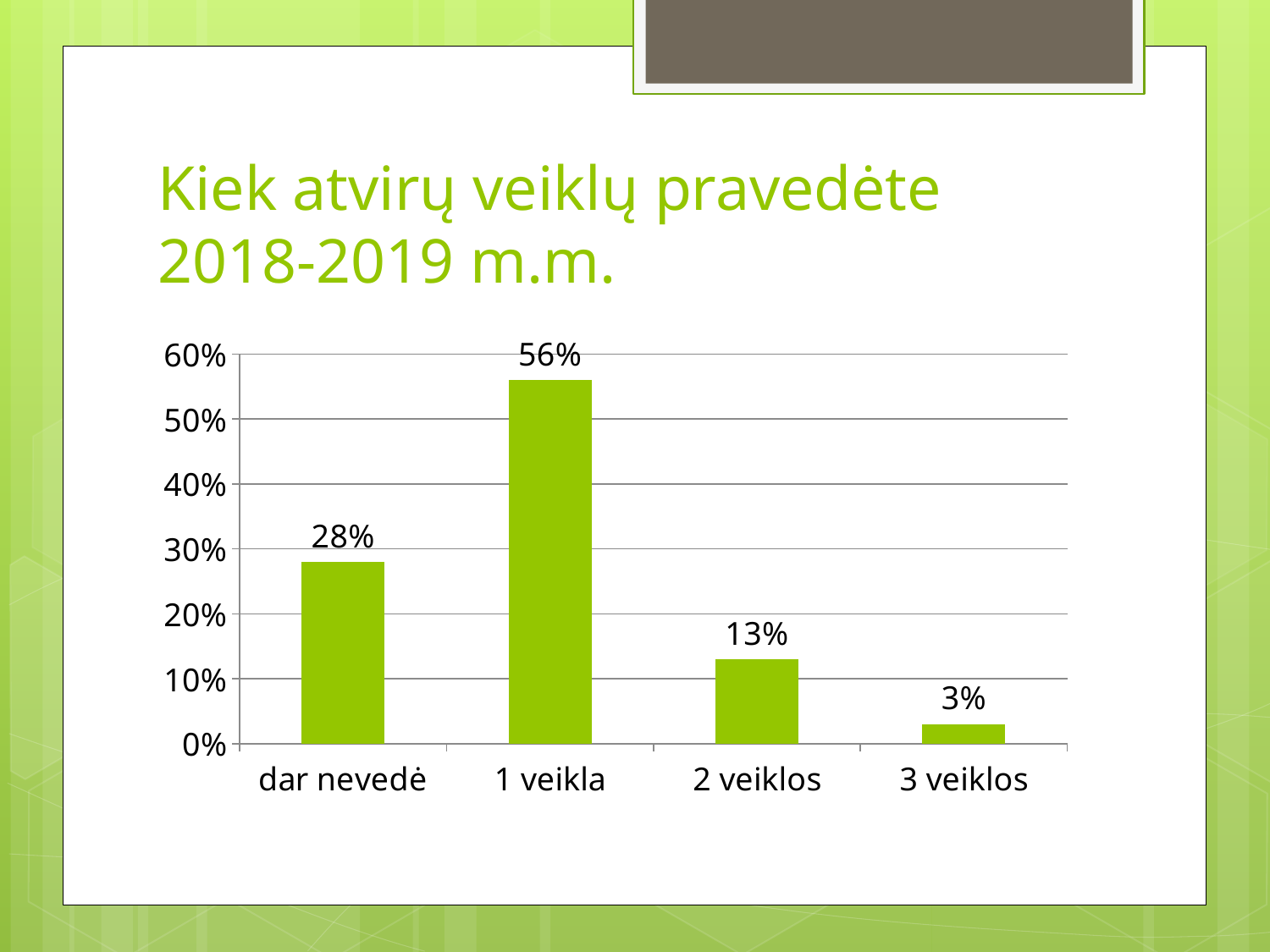
Which category has the lowest value? 3 veiklos What is the value for "2 veiklos"? 13% What is the value for "dar nevedė"? 28% What is the value for "1 veikla"? 56% Which category has the highest value? 1 veikla How many categories are shown on the x axis? 4 What is the value for "3 veiklos"? 3% What is the title of the slide? Kiek atvirų veiklų pravedėte 2018-2019 m.m. What kind of chart is shown on the slide? bar chart What is the difference between the values for "1 veikla" and "dar nevedė"? 28% Is the value for "2 veiklos" greater or less than 20%? less Which is larger, the value for "dar nevedė" or the value for "2 veiklos"? dar nevedė